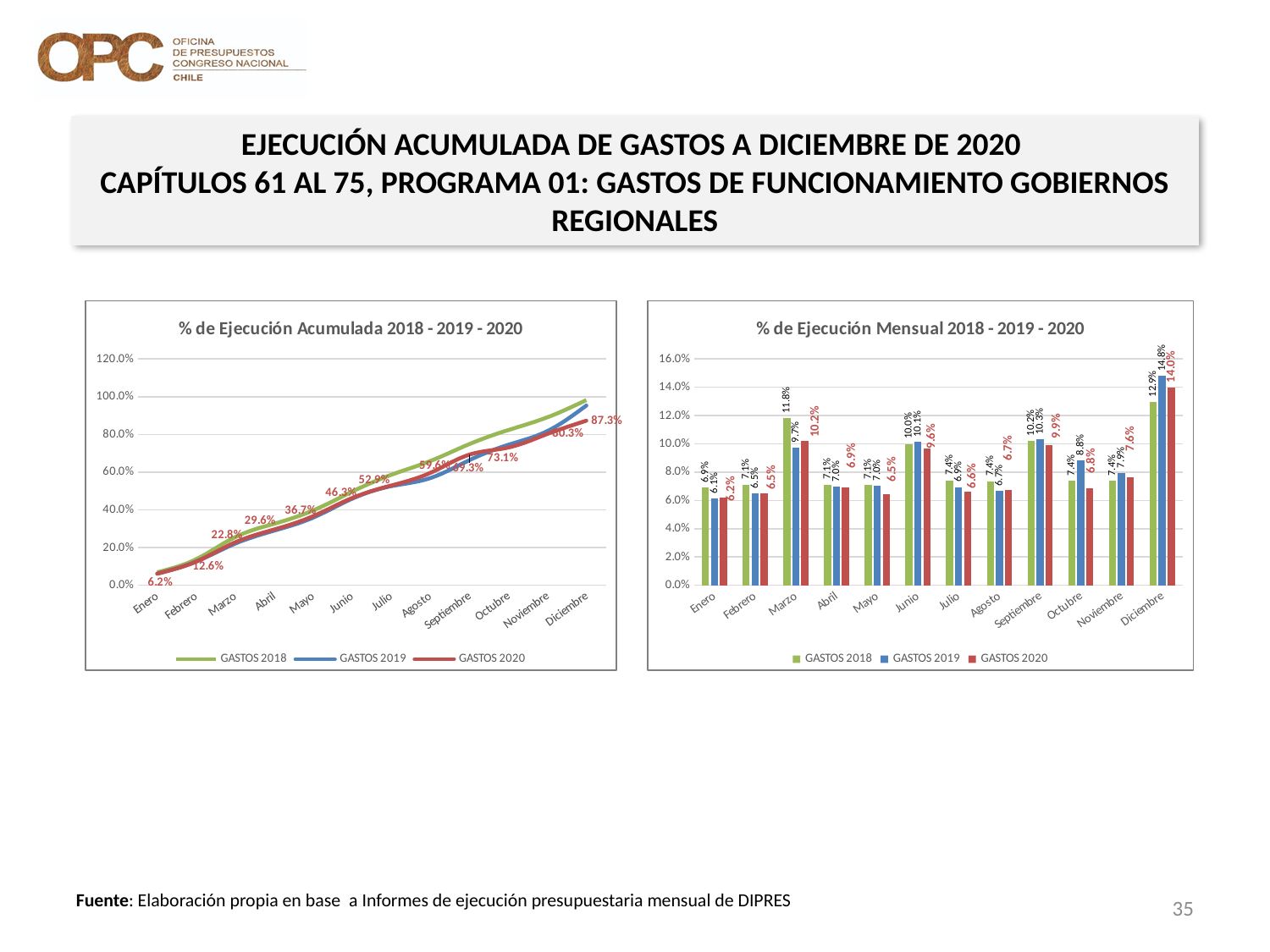
In the right chart '% de Ejecución Mensual 2018 - 2019 - 2020', what is the difference between GASTOS 2019 and GASTOS 2020 in Diciembre? 0.8 percentage points In the right chart '% de Ejecución Mensual 2018 - 2019 - 2020', what is the value for GASTOS 2018 in Marzo? 11.8% In the left chart '% de Ejecución Acumulada 2018 - 2019 - 2020', what is the value for GASTOS 2020 in Enero? 6.2% In the left chart '% de Ejecución Acumulada 2018 - 2019 - 2020', does the GASTOS 2020 line rise or fall from Enero to Diciembre? Rises In the right chart '% de Ejecución Mensual 2018 - 2019 - 2020', which month has the highest value for GASTOS 2019? Diciembre What kind of chart is the left chart titled '% de Ejecución Acumulada 2018 - 2019 - 2020'? Line chart How many series does the legend of the right chart '% de Ejecución Mensual 2018 - 2019 - 2020' list? 3 In the right chart '% de Ejecución Mensual 2018 - 2019 - 2020', which month has the lowest value for GASTOS 2020? Enero What kind of chart is the right chart titled '% de Ejecución Mensual 2018 - 2019 - 2020'? Bar chart In the right chart '% de Ejecución Mensual 2018 - 2019 - 2020', what is the value for GASTOS 2020 in Diciembre? 14.0% In the left chart '% de Ejecución Acumulada 2018 - 2019 - 2020', what is the value for GASTOS 2020 in Diciembre? 87.3% In the left chart '% de Ejecución Acumulada 2018 - 2019 - 2020', is the value for GASTOS 2018 in Diciembre greater or less than 80.0%? greater